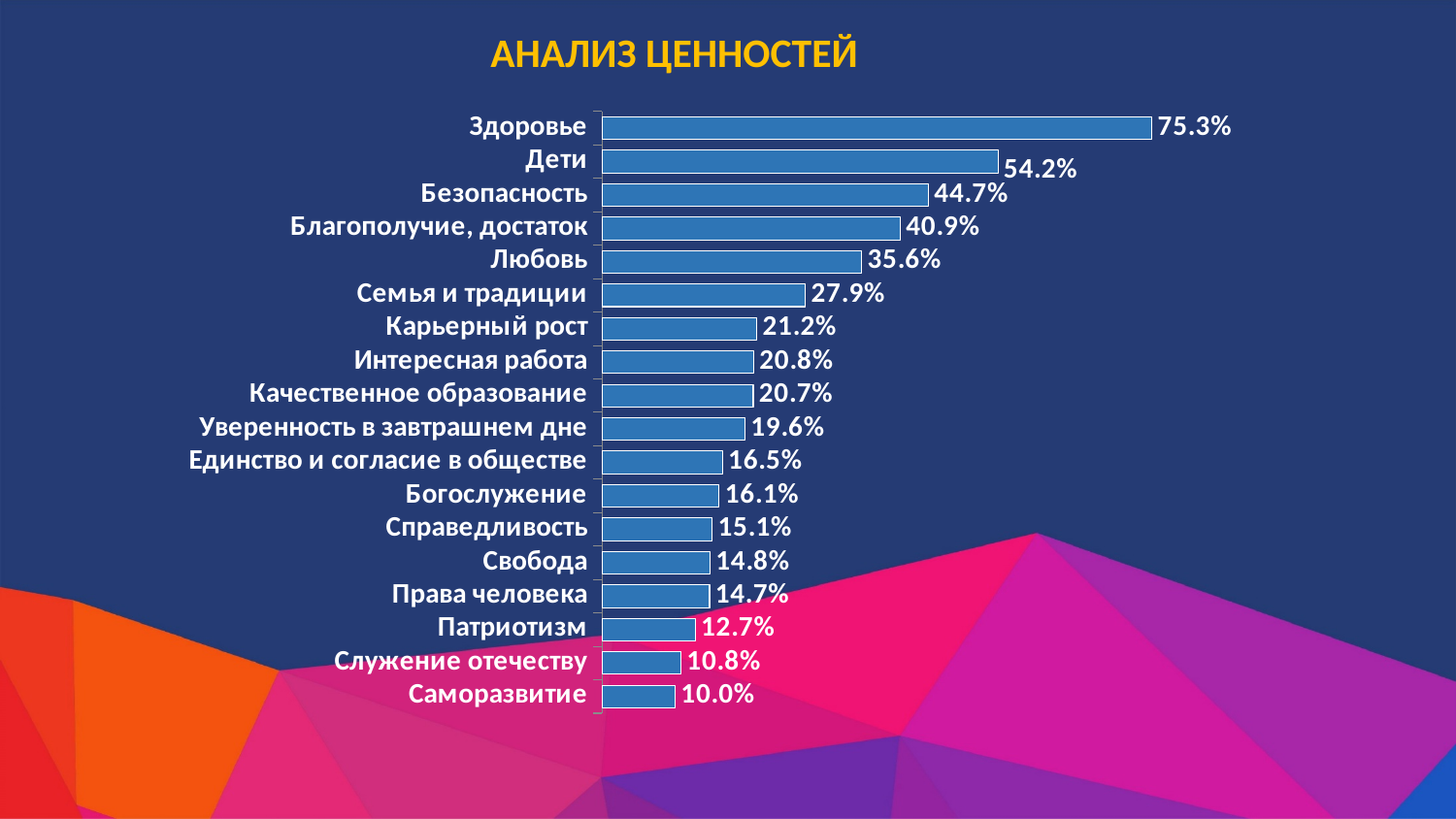
What type of chart is shown on the slide? Bar chart What is the value for Уверенность в завтрашнем дне? 19.6% What is the value for Патриотизм? 12.7% What is the difference between the values for Безопасность and Любовь? 9.1% What is the title of the chart? АНАЛИЗ ЦЕННОСТЕЙ What is the value for Семья и традиции? 27.9% How many categories are shown in the chart? 18 What is the value for Здоровье? 75.3% Which category has the lowest value? Саморазвитие Which category has the highest value? Здоровье What is the difference between the values for Здоровье and Дети? 21.1% Which is larger, the value for Богослужение or the value for Свобода? Богослужение